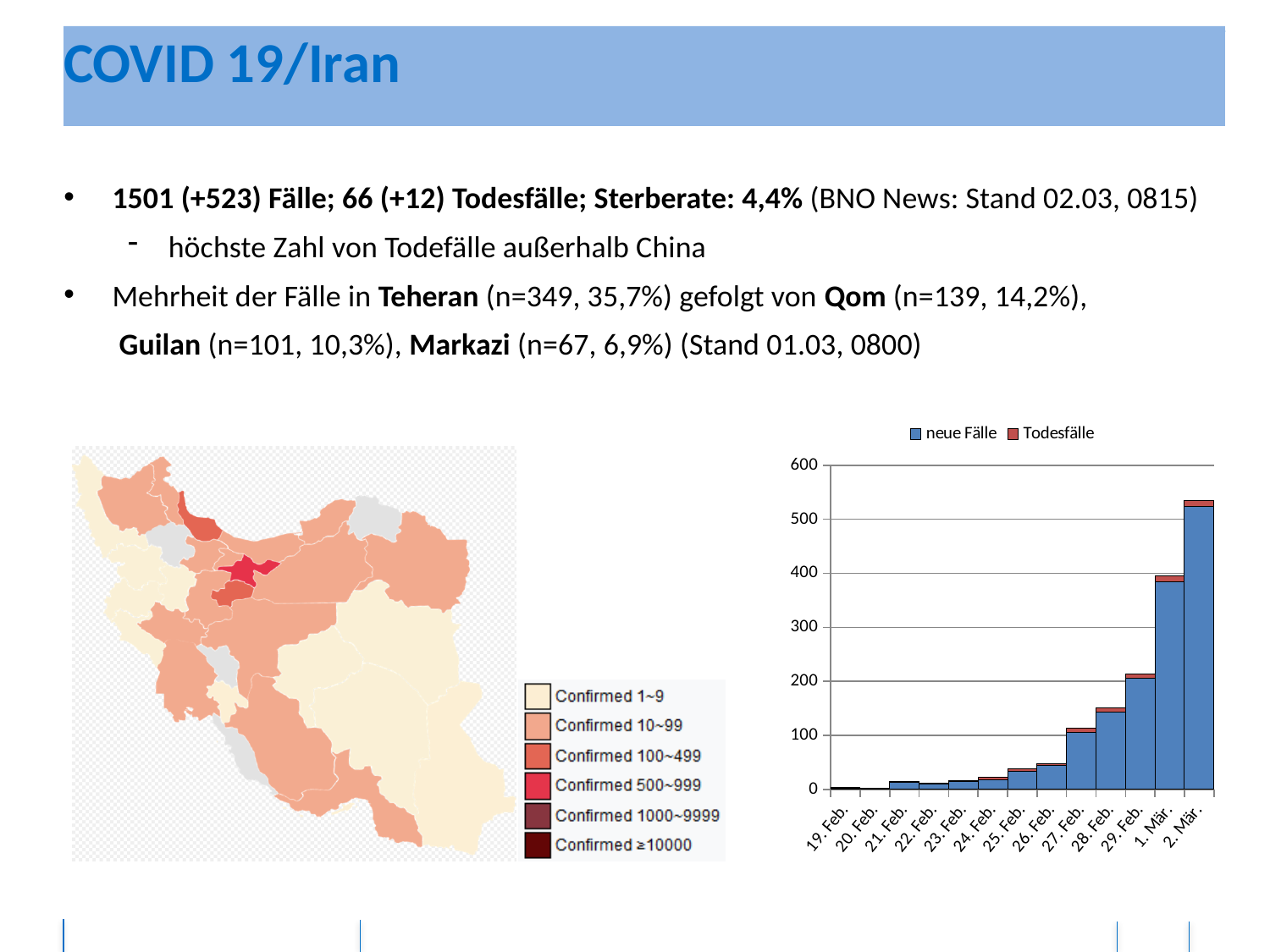
Is the bar for 29. Feb. greater or less than 300? less How many series does the legend of the bar chart list? 2 Which colour represents the series 'neue Fälle' in the bar chart? blue Is the bar for 1. Mär. greater or less than 300? greater How many dates are shown on the x axis of the bar chart? 13 Which two series are listed in the legend of the bar chart? neue Fälle and Todesfälle Which bar is taller in the chart, 1. Mär. or 2. Mär.? 2. Mär. What kind of chart is shown on the right side of the slide? bar chart Is the bar for 26. Feb. greater or less than 100? less Do the bars in the chart generally rise or fall from 19. Feb. to 2. Mär.? rise Which date has the highest bar in the bar chart? 2. Mär.